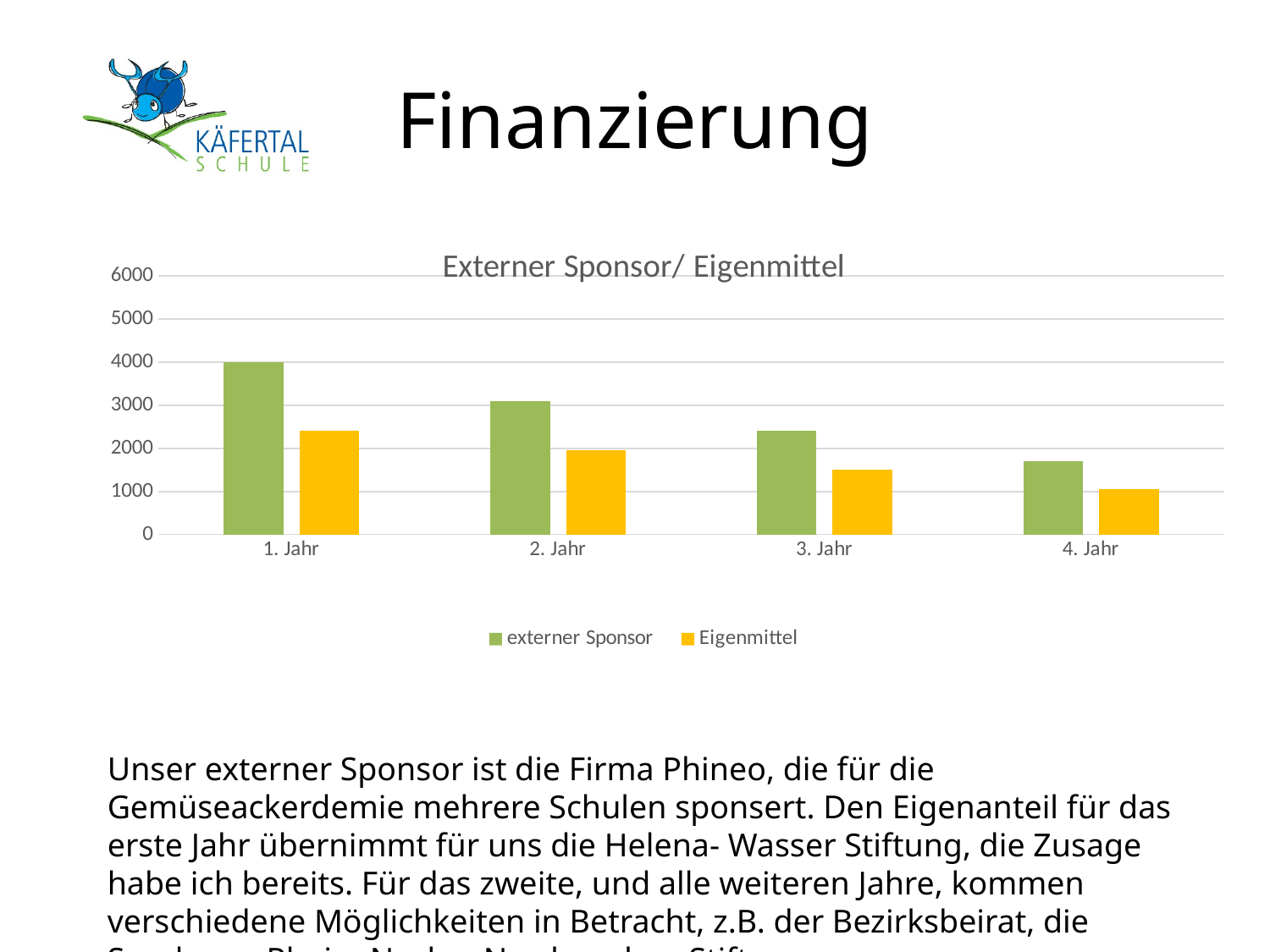
Is the Eigenmittel value for 4. Jahr greater or less than 2000? less What is the title of the chart? Externer Sponsor/ Eigenmittel Is the Eigenmittel value for 3. Jahr greater or less than 2000? less What kind of chart is shown on the slide? bar chart Do the externer Sponsor values rise or fall from 1. Jahr to 4. Jahr? fall In which year is the Eigenmittel value lowest? 4. Jahr Is the externer Sponsor value for 2. Jahr greater or less than 2000? greater In 1. Jahr, which is larger: externer Sponsor or Eigenmittel? externer Sponsor How many series does the legend list? 2 Which colour represents the Eigenmittel series? yellow How many categories (years) are shown on the x axis? 4 In which year is the externer Sponsor value highest? 1. Jahr